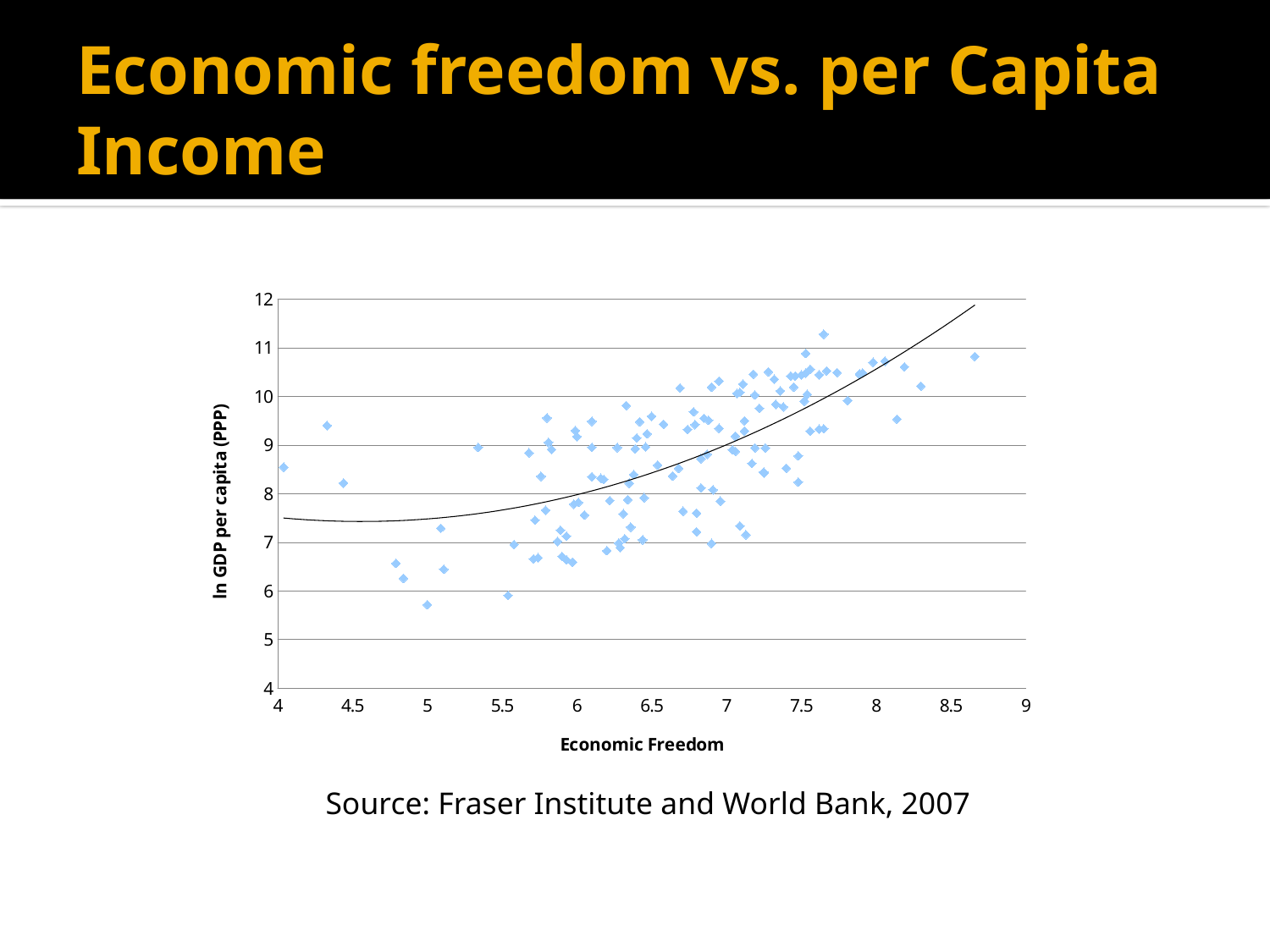
Does the fitted curve on the chart slope upward or downward as Economic Freedom increases from 6 to 9? Upward What is the label of the x axis of the chart? Economic Freedom Is the value of the fitted curve at Economic Freedom 4 greater or less than 7? greater What is the label of the y axis of the chart? ln GDP per capita (PPP) Is the value of the fitted curve at Economic Freedom 7 greater or less than 10? less What kind of chart is shown on the slide? Scatter plot Do the plotted values of ln GDP per capita generally rise or fall as Economic Freedom increases along the x axis? Rise Is the value of the fitted curve at Economic Freedom 8.5 greater or less than 11? greater